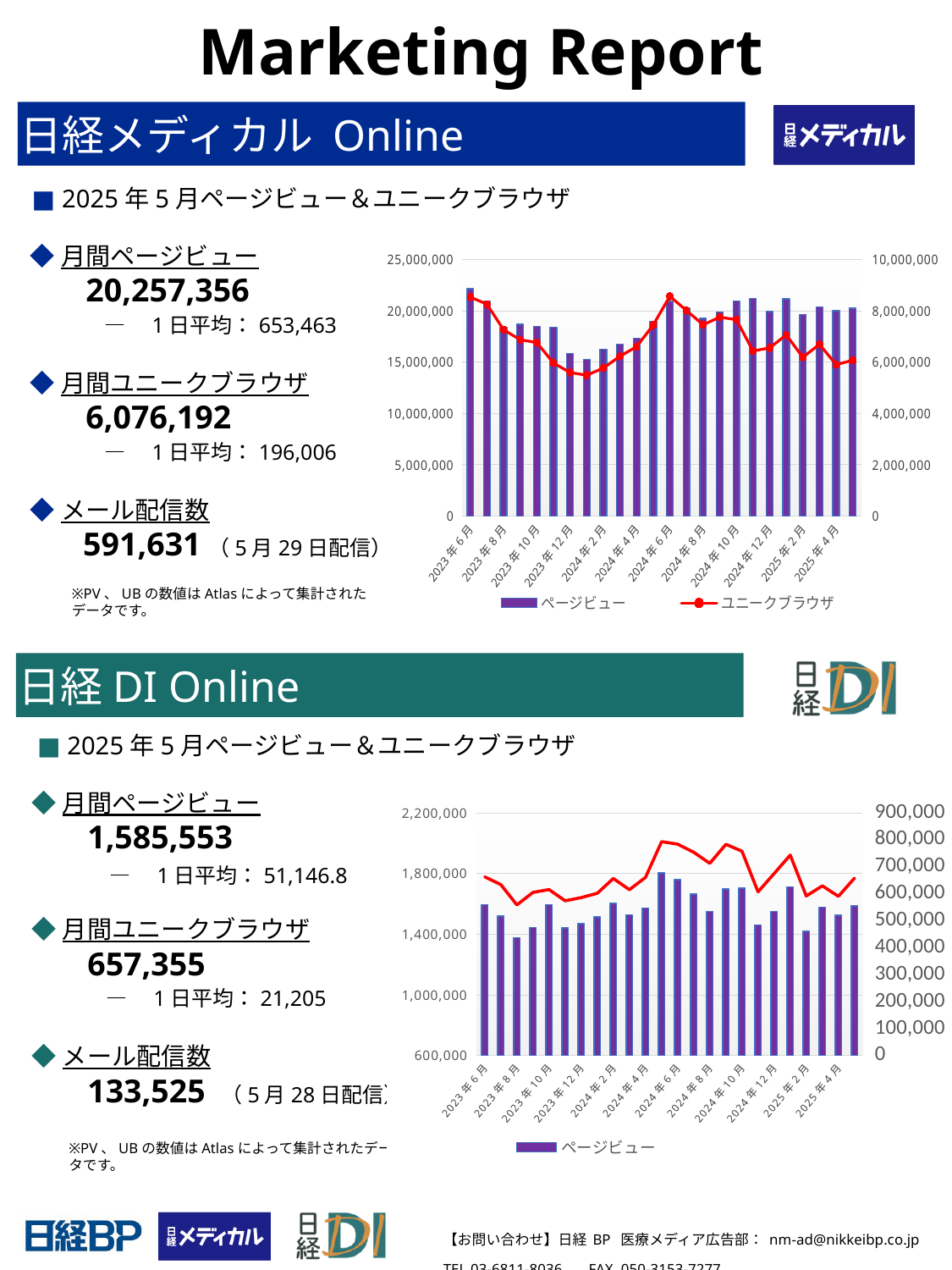
In the top chart (日経メディカル Online), how many series does the legend list? 2 In the bottom chart (日経 DI Online), is the red line value for 2024年6月 greater or less than 700,000? greater In the top chart (日経メディカル Online), is the ページビュー value for 2024年1月 greater or less than 20,000,000? less In the bottom chart (日経 DI Online), which month has the highest ページビュー value? 2024年5月 In the top chart (日経メディカル Online), is the ページビュー value for 2023年6月 greater or less than 20,000,000? greater In the top chart (日経メディカル Online), do the ページビュー values rise or fall from 2023年6月 to 2024年1月? fall In the top chart (日経メディカル Online), what are the two legend entries? ページビュー and ユニークブラウザ In the top chart (日経メディカル Online), which month has the larger ページビュー value, 2023年6月 or 2024年1月? 2023年6月 In the top chart (日経メディカル Online), how many months are plotted along the x axis? 24 What kind of chart is the top chart (日経メディカル Online)? bar chart with a line